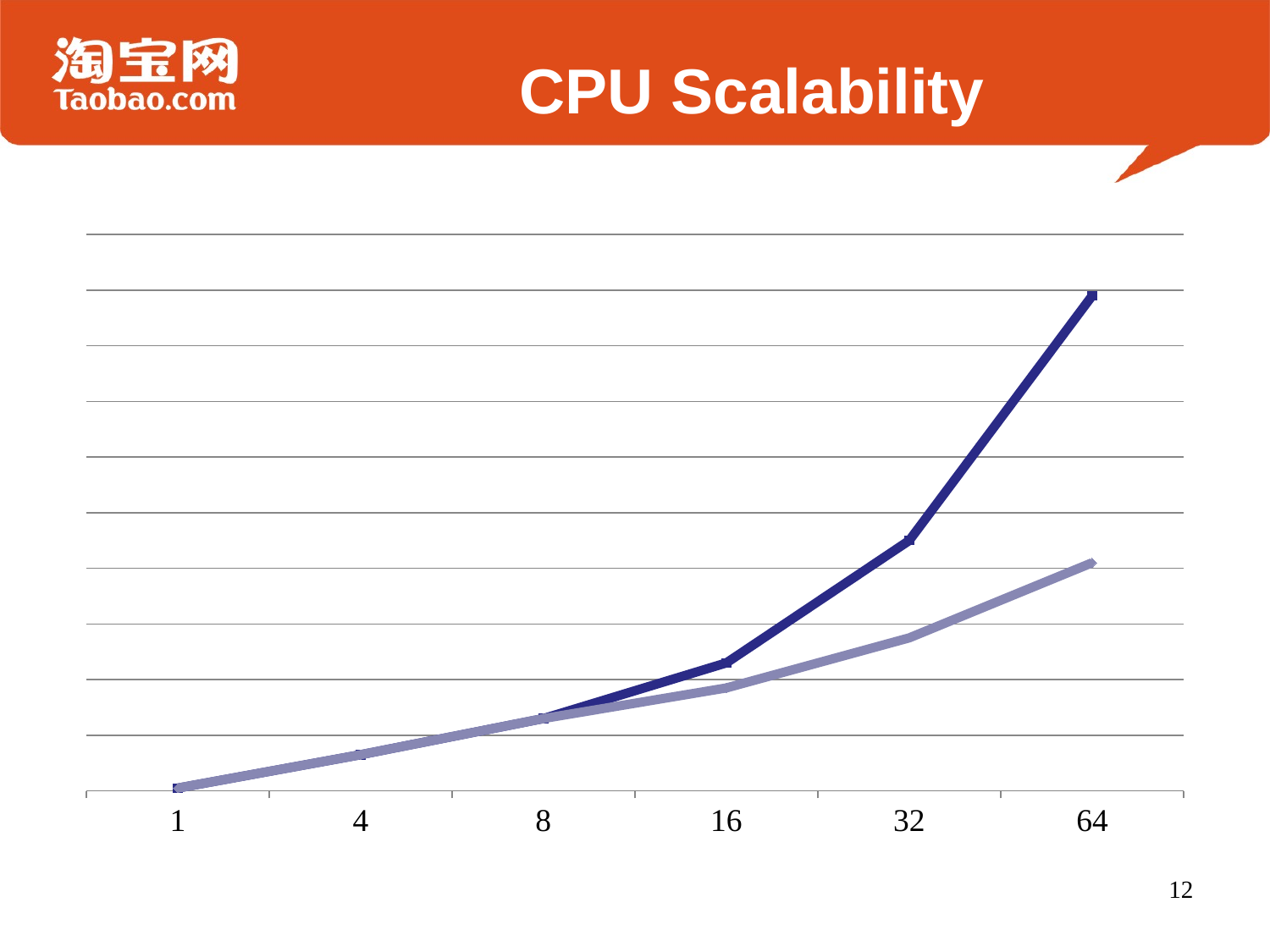
How many categories are labelled on the x axis? 6 How many lines are plotted on the chart? 2 What kind of chart is shown on the slide? line chart What is the title of the chart? CPU Scalability Do the values of the dark blue line rise or fall as the x axis goes from 1 to 64? rise At which x-axis category does the dark blue line reach its highest value? 64 Do the values of the light purple line rise or fall as the x axis goes from 1 to 64? rise At which x-axis category does the dark blue line have its lowest value? 1 At x = 64, which line has the higher value, the dark blue line or the light purple line? dark blue line At x = 32, which line has the higher value, the dark blue line or the light purple line? dark blue line At which x-axis category does the light purple line reach its highest value? 64 What is the last category label on the x axis? 64